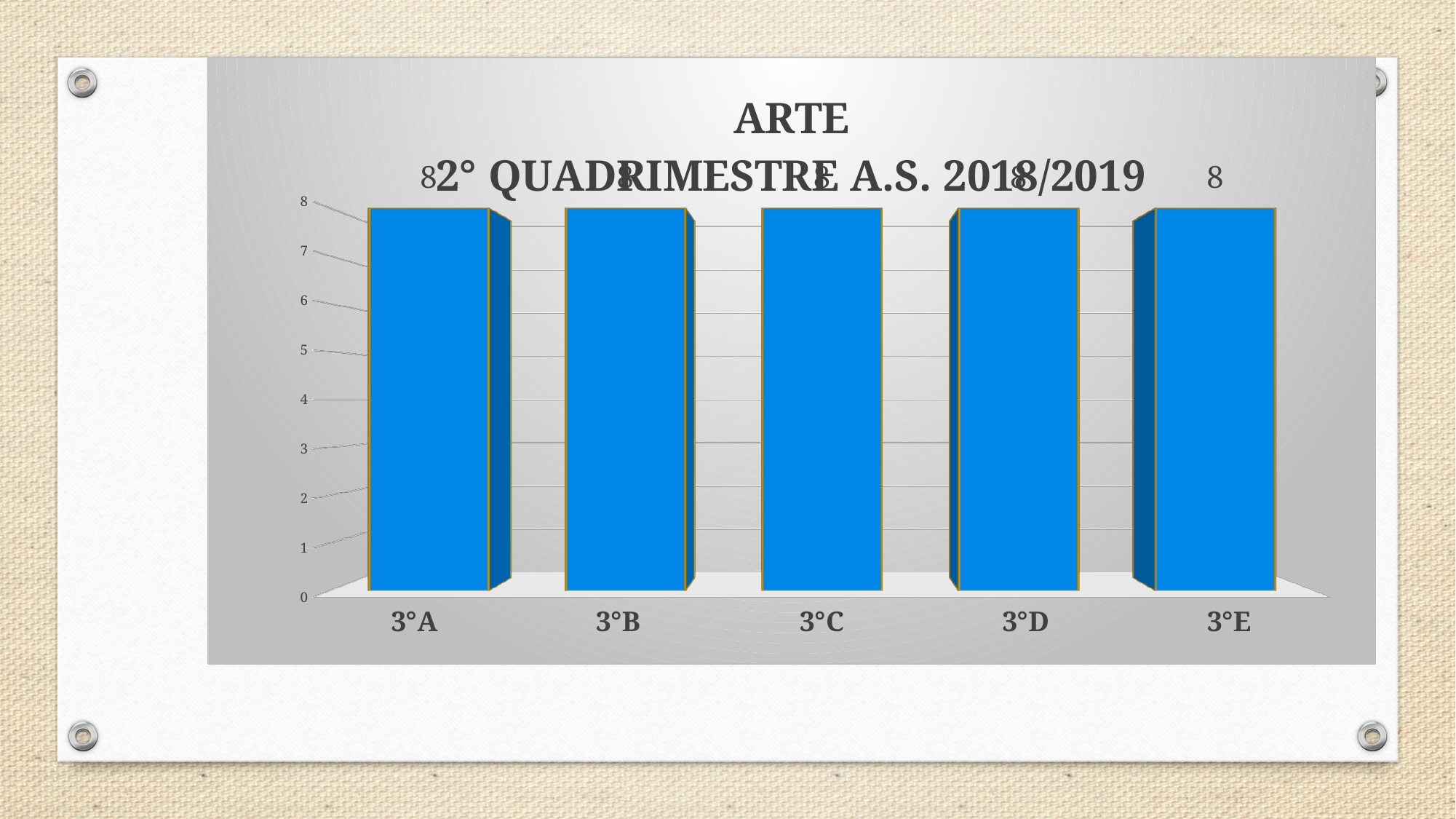
Is the value for 3°B larger than, smaller than, or equal to the value for 3°D? equal How many categories are shown on the x axis? 5 Is the value for 3°C greater or less than 5? greater What is the difference between the values for 3°A and 3°B? 0 What is the highest value shown on the vertical axis? 8 What is the value for 3°D? 8 What is the value for 3°A? 8 What is the title of the chart? ARTE 2° QUADRIMESTRE A.S. 2018/2019 What kind of chart is shown on the slide? bar chart What is the value for 3°E? 8 What is the value for 3°C? 8 Do the values rise, fall, or stay the same from 3°A to 3°E? stay the same